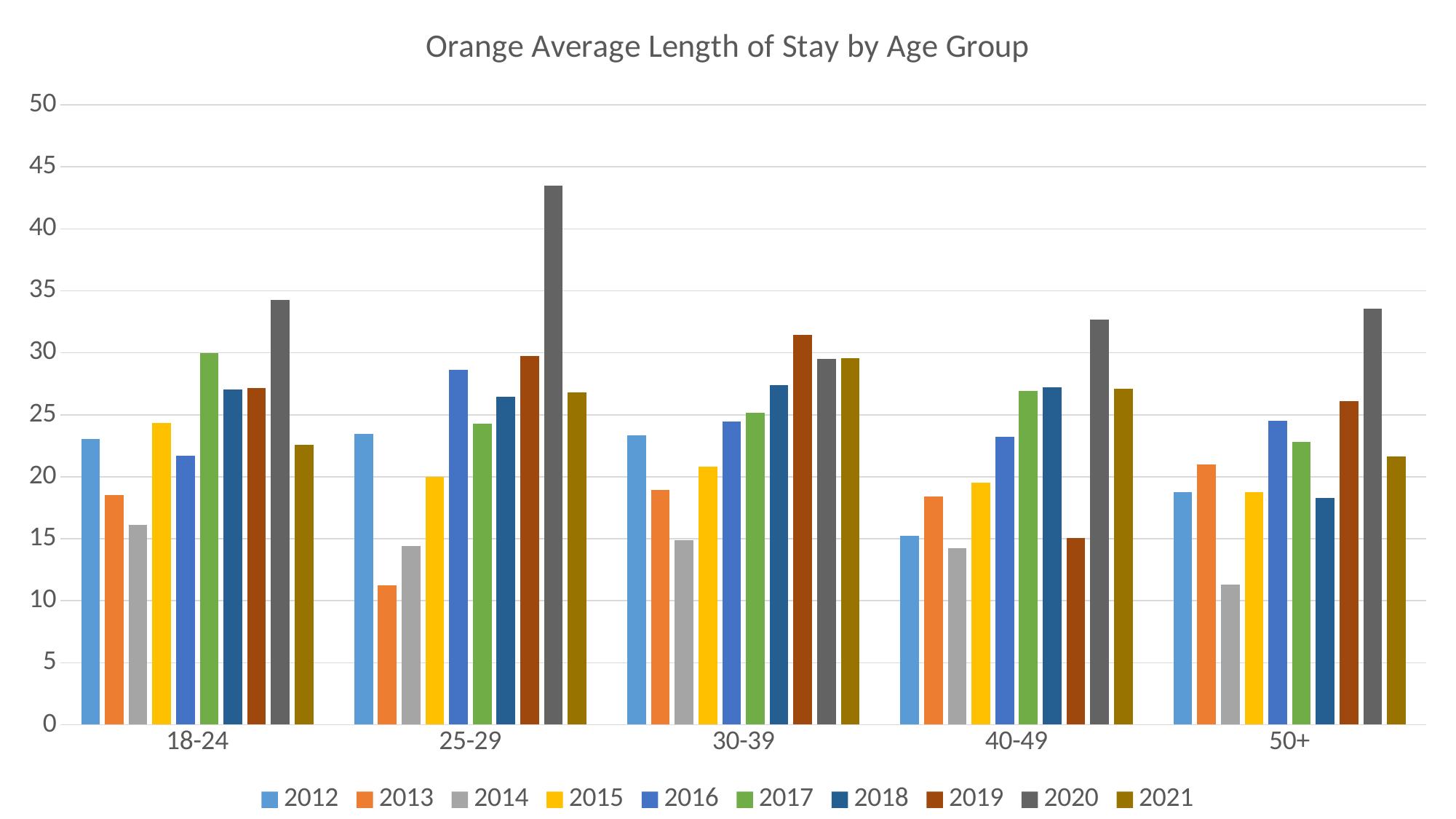
How many series (years) does the legend list? 10 How many age groups are shown on the x axis? 5 Which age group has the highest value for 2020? 25-29 For the 40-49 age group, which is larger: the 2020 value or the 2019 value? 2020 Which age group has the lowest value for 2012? 40-49 What type of chart is shown on the slide? Bar chart Is the 2019 value for the 30-39 age group greater or less than 30? greater For the 18-24 age group, which is larger: the 2017 value or the 2012 value? 2017 Within the 50+ age group, which year has the lowest value? 2014 What is the title of the chart? Orange Average Length of Stay by Age Group Is the 2013 value for the 25-29 age group greater or less than 15? less Is the 2020 value for the 25-29 age group greater or less than 40? greater